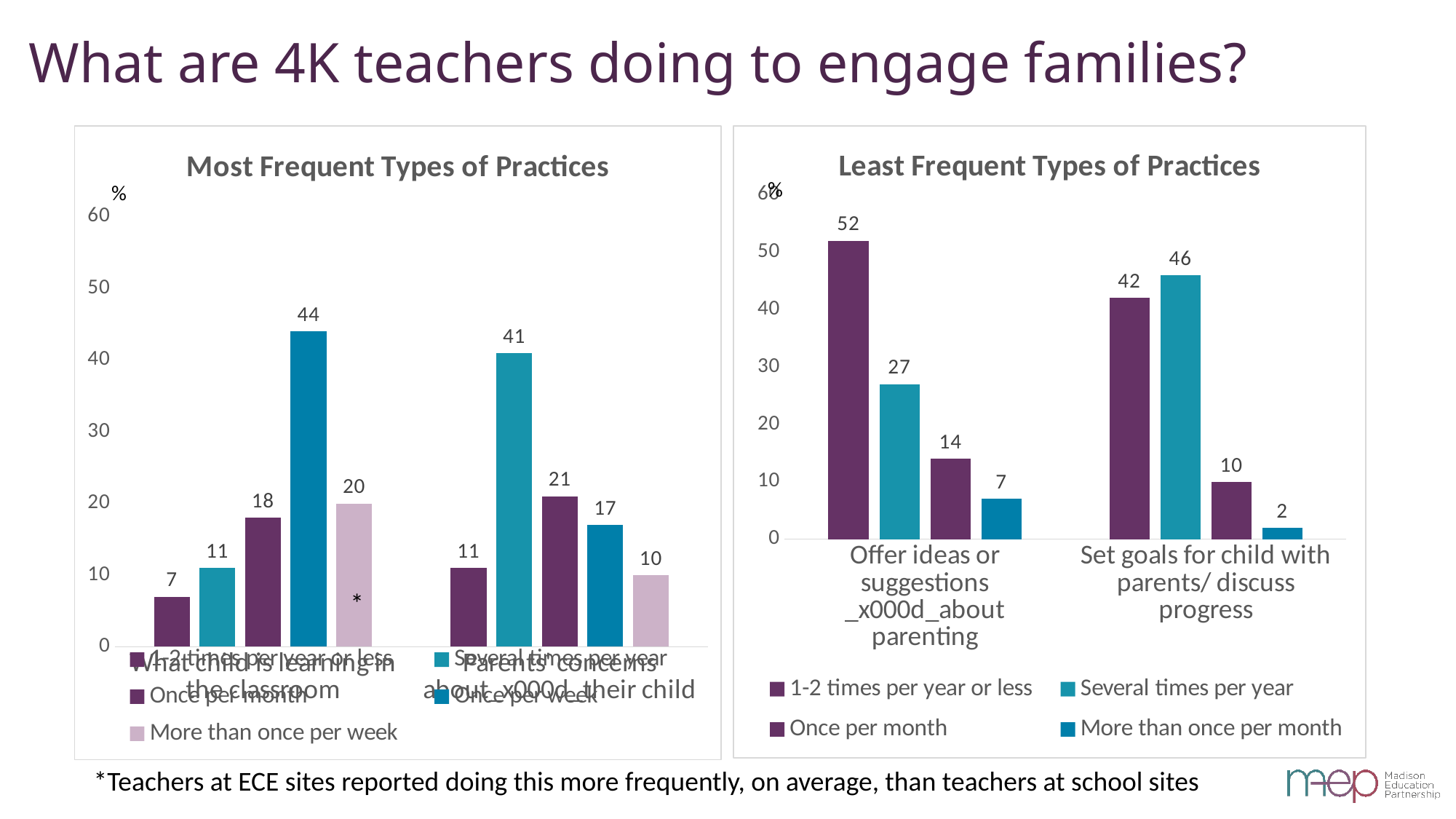
In the 'Most Frequent Types of Practices' chart, what is the value for 'More than once per week' for 'What child is learning in the classroom'? 20 In the 'Most Frequent Types of Practices' chart, what is the value for 'Once per week' for 'What child is learning in the classroom'? 44 How many series does the legend of the 'Least Frequent Types of Practices' chart list? 4 How many series does the legend of the 'Most Frequent Types of Practices' chart list? 5 In the 'Most Frequent Types of Practices' chart, what is the value for 'Several times per year' for 'Parents' concerns about their child'? 41 In the 'Least Frequent Types of Practices' chart, which series has the lowest value for 'Set goals for child with parents/ discuss progress'? More than once per month In the 'Least Frequent Types of Practices' chart, what is the value for 'More than once per month' for 'Offer ideas or suggestions about parenting'? 7 In the 'Least Frequent Types of Practices' chart, what is the value for 'Several times per year' for 'Set goals for child with parents/ discuss progress'? 46 In the 'Least Frequent Types of Practices' chart, which series has the highest value for 'Offer ideas or suggestions about parenting'? 1-2 times per year or less In the 'Least Frequent Types of Practices' chart, which is larger: 'Several times per year' for 'Offer ideas or suggestions about parenting' or 'Several times per year' for 'Set goals for child with parents/ discuss progress'? Set goals for child with parents/ discuss progress What kind of chart is the 'Least Frequent Types of Practices' chart? Bar chart In the 'Most Frequent Types of Practices' chart, what is the difference between the 'Once per week' values for 'What child is learning in the classroom' and 'Parents' concerns about their child'? 27